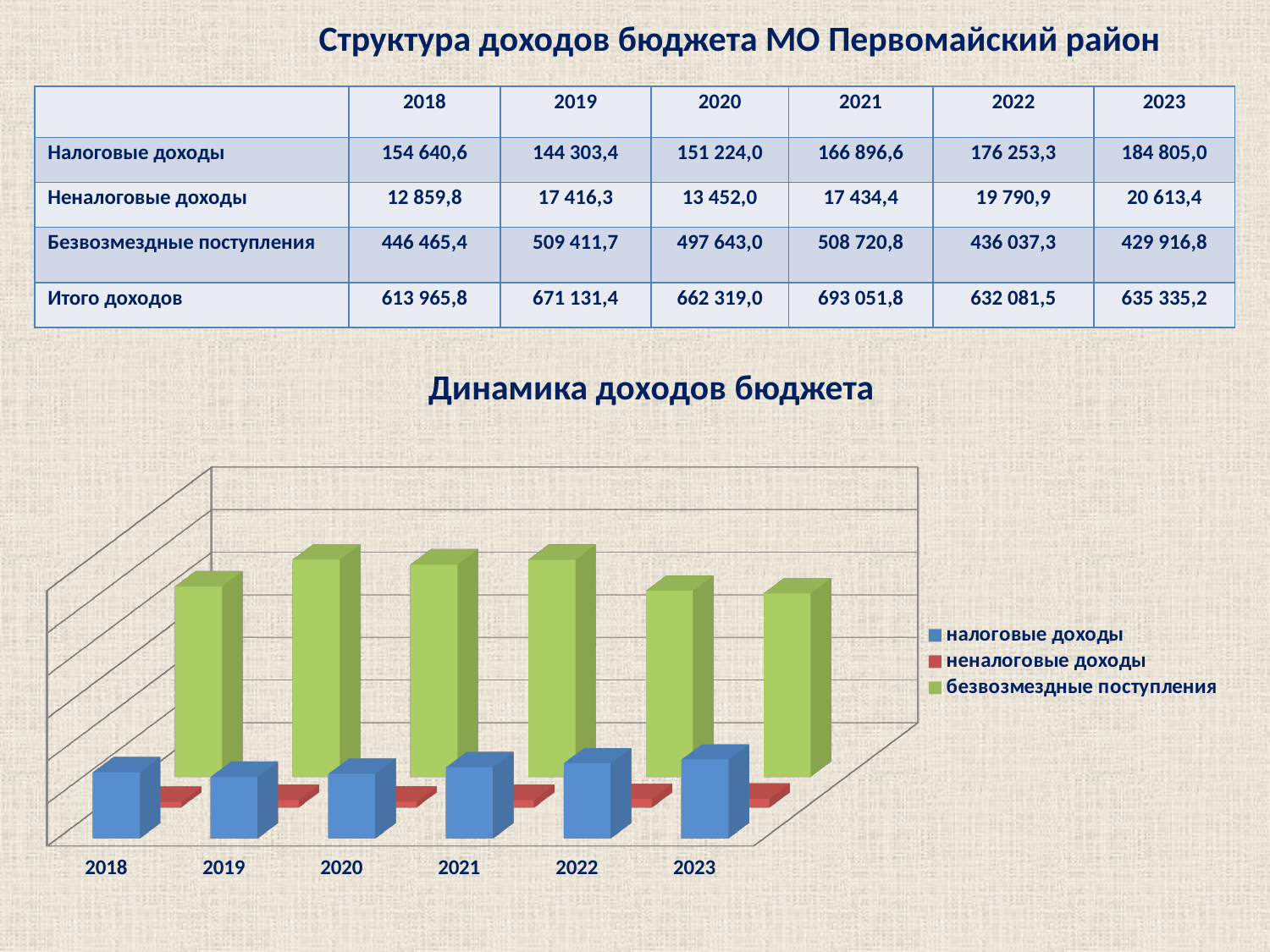
According to the table on the slide, what is the value of Итого доходов for 2021? 693 051,8 How many series does the legend of the chart "Динамика доходов бюджета" list? 3 What kind of chart is shown under the title "Динамика доходов бюджета"? bar chart What is the title of the chart on the slide? Динамика доходов бюджета In the chart "Динамика доходов бюджета", which series has the tallest bars in every year? безвозмездные поступления In the chart "Динамика доходов бюджета", for 2021, which is larger: налоговые доходы or безвозмездные поступления? безвозмездные поступления How many years are shown on the x axis of the chart "Динамика доходов бюджета"? 6 According to the table on the slide, what is the value of Налоговые доходы for 2023? 184 805,0 In the chart "Динамика доходов бюджета", do the bars for налоговые доходы rise or fall from 2019 to 2023? rise In the chart "Динамика доходов бюджета", which series is shown in green? безвозмездные поступления In the chart "Динамика доходов бюджета", which series has the smallest bars in every year? неналоговые доходы In the chart "Динамика доходов бюджета", do the bars for безвозмездные поступления rise or fall from 2021 to 2023? fall